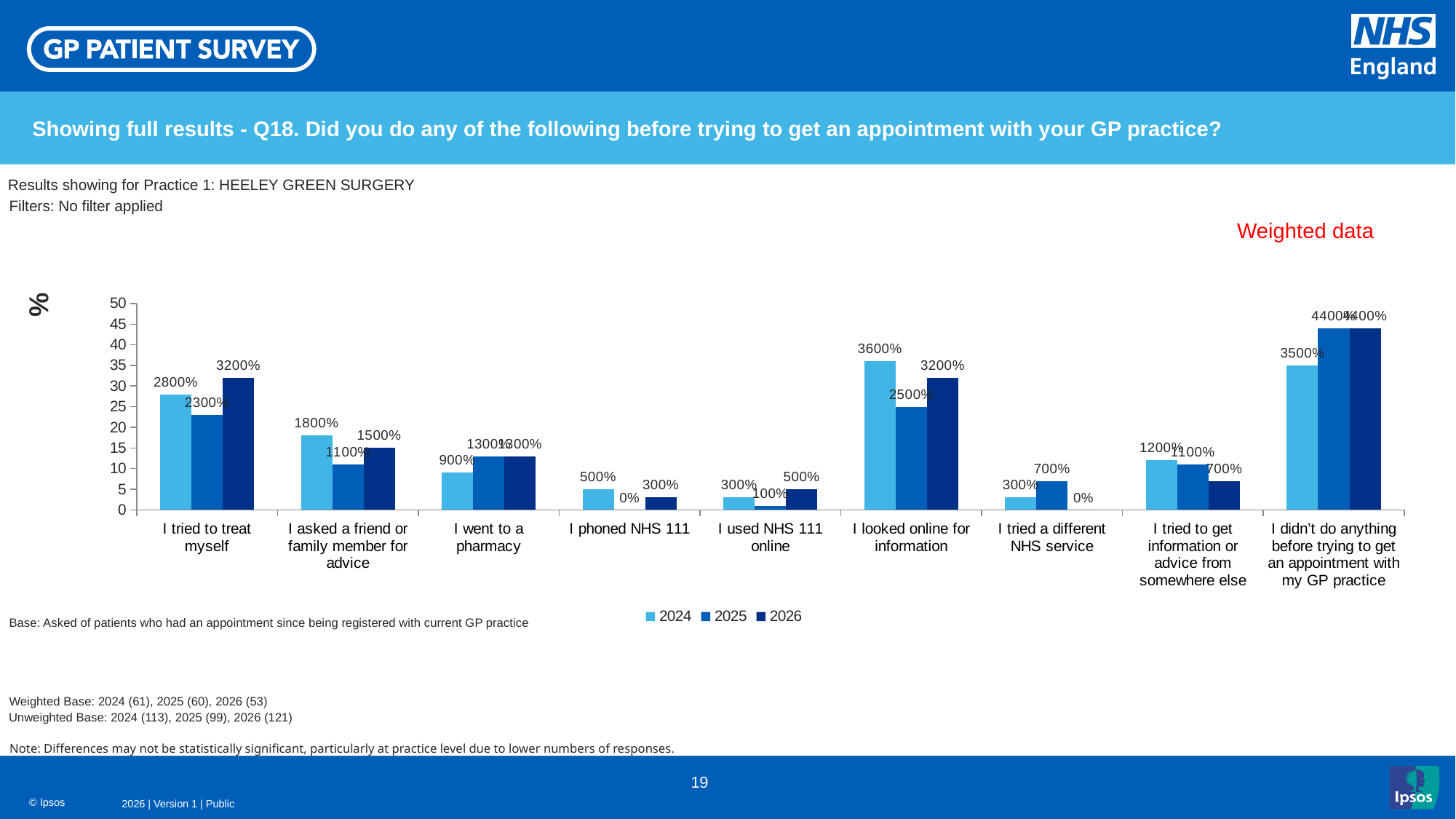
What is the difference between the 2024 and 2025 values for 'I looked online for information', as labelled? 1100% What is the 2024 value for 'I tried to treat myself'? 2800% Which category has the lowest 2026 value? I tried a different NHS service How many categories are shown on the x axis? 9 What kind of chart is shown on the slide? bar chart Which category has the highest 2024 value? I looked online for information Is the 2025 bar for 'I didn't do anything before trying to get an appointment with my GP practice' above or below the 40 mark on the axis? above For 'I tried to treat myself', which year has the larger value, 2024 or 2025? 2024 What is the 2026 value for 'I looked online for information'? 3200% How many series does the legend list? 3 What is the 2024 value for 'I asked a friend or family member for advice'? 1800% What is the 2025 value for 'I phoned NHS 111'? 0%